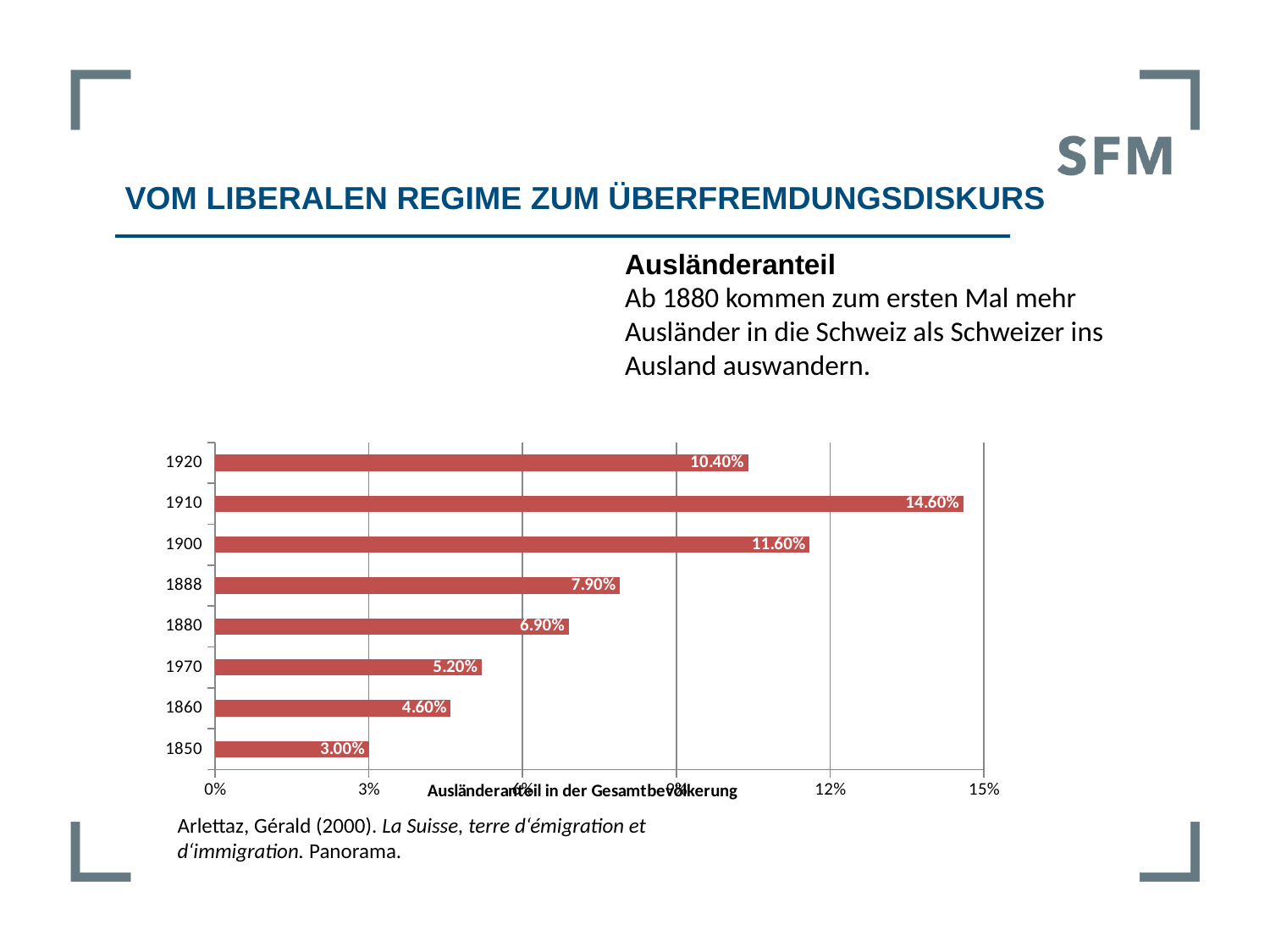
Which is larger, the value for 1900 or the value for 1920? 1900 What is the value for 1910? 14.60% What is the value for 1888? 7.90% Which category has the highest value? 1910 What is the value for 1850? 3.00% What kind of chart is shown on the slide? bar chart Is the value for 1880 greater or less than 6%? greater What is the difference between the values for 1860 and 1850? 1.60% What is the difference between the values for 1910 and 1920? 4.20% What is the title of the horizontal axis of the chart? Ausländeranteil in der Gesamtbevölkerung How many categories are shown on the chart? 8 Which category has the lowest value? 1850